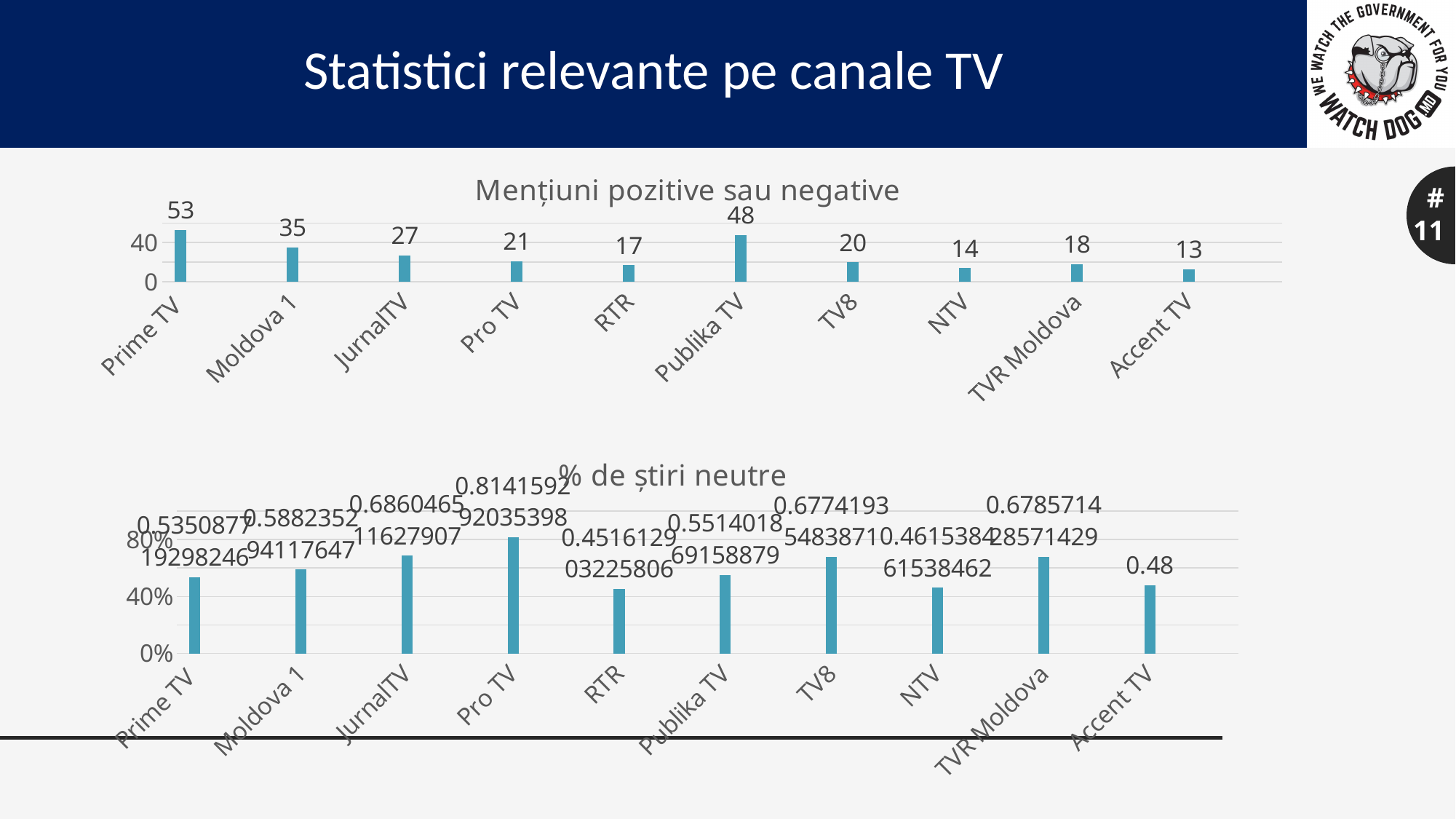
In the chart titled "Mențiuni pozitive sau negative", what is the value for Publika TV? 48 In the chart titled "% de știri neutre", which channel has the highest bar? Pro TV In the chart titled "% de știri neutre", is the value for Pro TV greater or less than 80%? greater In the chart titled "Mențiuni pozitive sau negative", which has a larger value, JurnalTV or TV8? JurnalTV In the chart titled "Mențiuni pozitive sau negative", what is the value for Prime TV? 53 In the chart titled "% de știri neutre", what is the value labelled for Accent TV? 0.48 In the chart titled "Mențiuni pozitive sau negative", how many channels are shown? 10 In the chart titled "% de știri neutre", is the value for RTR greater or less than 80%? less In the chart titled "Mențiuni pozitive sau negative", what is the difference between the values for Prime TV and Moldova 1? 18 In the chart titled "Mențiuni pozitive sau negative", which channel has the lowest value? Accent TV In the chart titled "Mențiuni pozitive sau negative", which channel has the highest value? Prime TV What kind of chart is the top chart, "Mențiuni pozitive sau negative"? bar chart